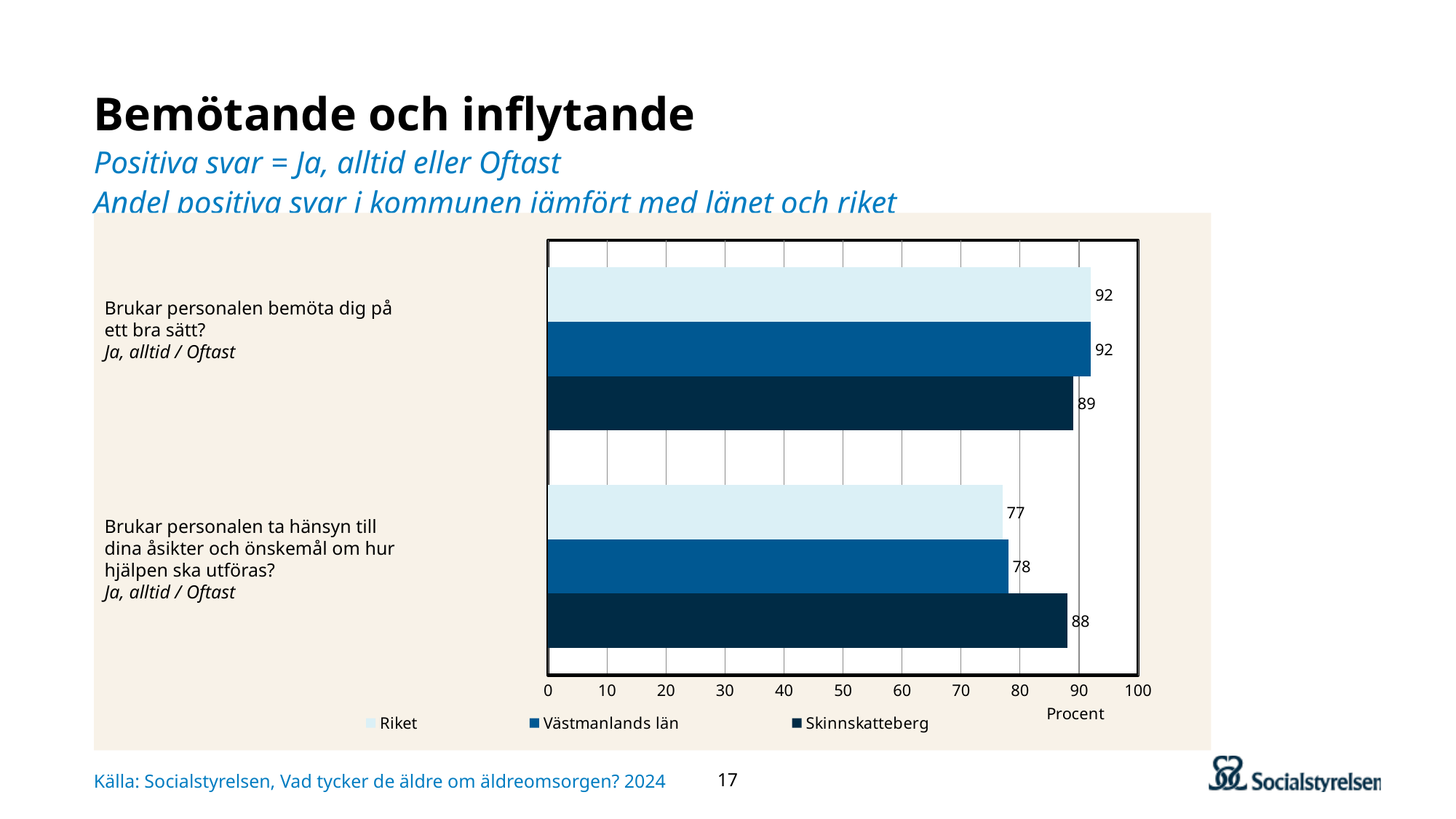
What is the value for Riket on "Brukar personalen ta hänsyn till dina åsikter och önskemål om hur hjälpen ska utföras?"? 77 How many series does the legend list? 3 Is the value for Riket on "Brukar personalen ta hänsyn till dina åsikter och önskemål om hur hjälpen ska utföras?" greater or less than 80? less Which is larger on "Brukar personalen bemöta dig på ett bra sätt?": Riket or Skinnskatteberg? Riket What is the label of the x axis? Procent Which series has the lowest value on "Brukar personalen bemöta dig på ett bra sätt?"? Skinnskatteberg Which series has the highest value on "Brukar personalen ta hänsyn till dina åsikter och önskemål om hur hjälpen ska utföras?"? Skinnskatteberg What is the value for Skinnskatteberg on "Brukar personalen bemöta dig på ett bra sätt?"? 89 What kind of chart is shown on the slide? Bar chart What is the value for Skinnskatteberg on "Brukar personalen ta hänsyn till dina åsikter och önskemål om hur hjälpen ska utföras?"? 88 What is the difference between Skinnskatteberg and Riket on "Brukar personalen ta hänsyn till dina åsikter och önskemål om hur hjälpen ska utföras?"? 11 What is the value for Västmanlands län on "Brukar personalen ta hänsyn till dina åsikter och önskemål om hur hjälpen ska utföras?"? 78